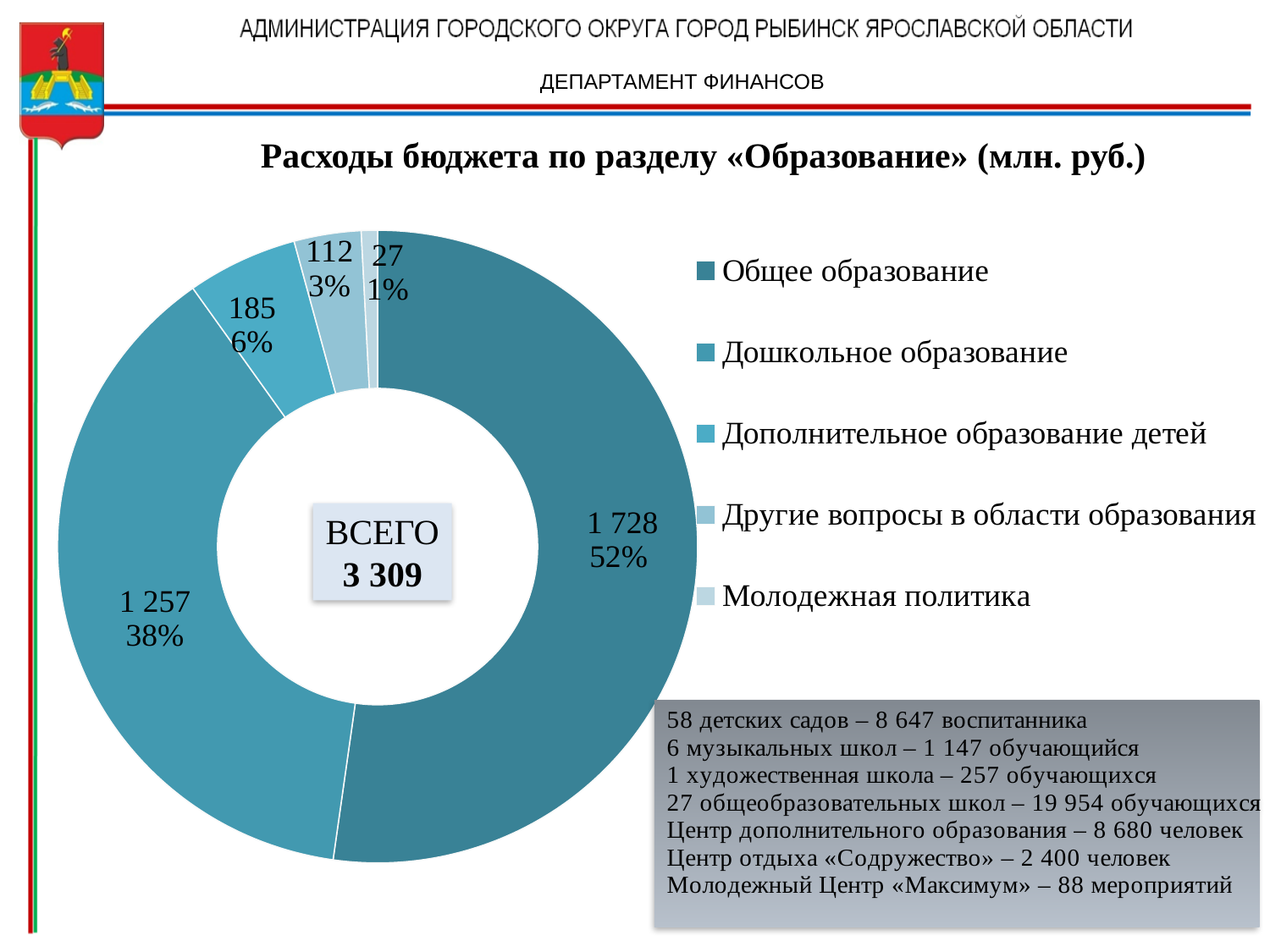
Which category has the smallest share of the chart? Молодежная политика What is the difference between the values for Общее образование and Дошкольное образование? 471 What share of the chart does Другие вопросы в области образования take? 3% What is the value for Дошкольное образование? 1 257 What kind of chart is shown on the slide? Pie (doughnut) chart What is the value for Молодежная политика? 27 What is the value for Общее образование? 1 728 What share of the chart does Дошкольное образование take? 38% Which category has the largest share of the chart? Общее образование Which is larger, the value for Дополнительное образование детей or the value for Другие вопросы в области образования? Дополнительное образование детей What is the value for Дополнительное образование детей? 185 How many categories does the chart show? 5